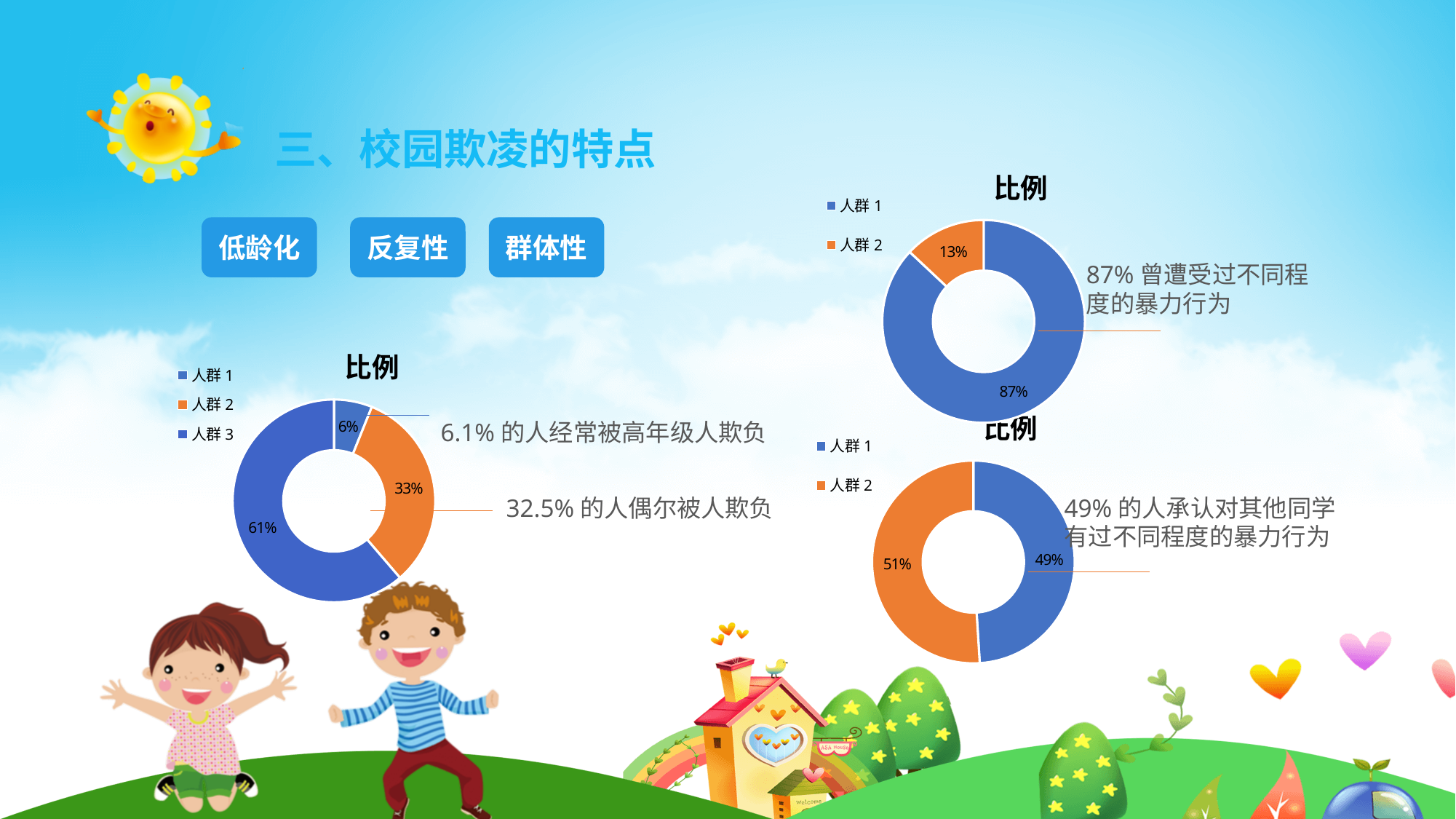
In the chart on the left of the slide, which category has the smallest share? 人群 1 In the bottom-right chart, which is larger, 人群 1 or 人群 2? 人群 2 What kind of chart is the chart on the left of the slide? Doughnut chart What is the title of the top-right chart? 比例 In the bottom-right chart, what is the value for 人群 2? 51% In the top-right chart, what is the difference between the values for 人群 1 and 人群 2? 74% In the top-right chart, what is the value for 人群 1? 87% How many doughnut charts are shown on the slide? 3 In the top-right chart, what is the value for 人群 2? 13% In the chart on the left of the slide, what is the value for 人群 2? 33% In the chart on the left of the slide, what is the value for 人群 3? 61% How many categories does the legend of the chart on the left of the slide list? 3